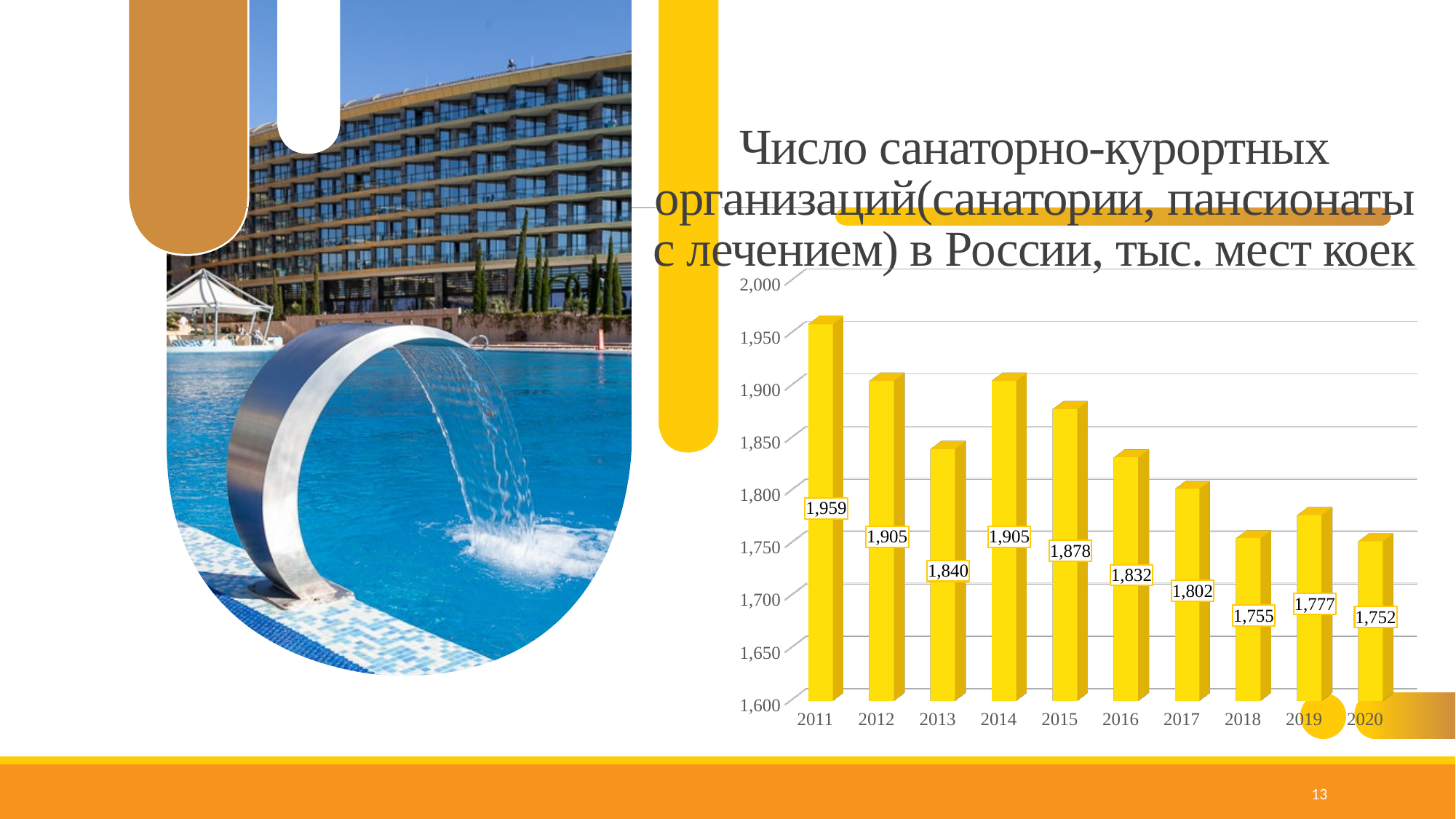
What is the value for 2016? 1,832 What is the difference between the values for 2018 and 2019? 22 Which year has the lowest value? 2020 Do the values generally rise or fall from 2011 to 2020? fall What is the value for 2020? 1,752 Which is larger, the value for 2015 or the value for 2017? 2015 Is the value for 2013 greater or less than 1,850? less What is the difference between the values for 2011 and 2020? 207 What kind of chart is shown on the slide? bar chart Which year has the highest value? 2011 How many years are shown on the x axis? 10 What is the value for 2011? 1,959